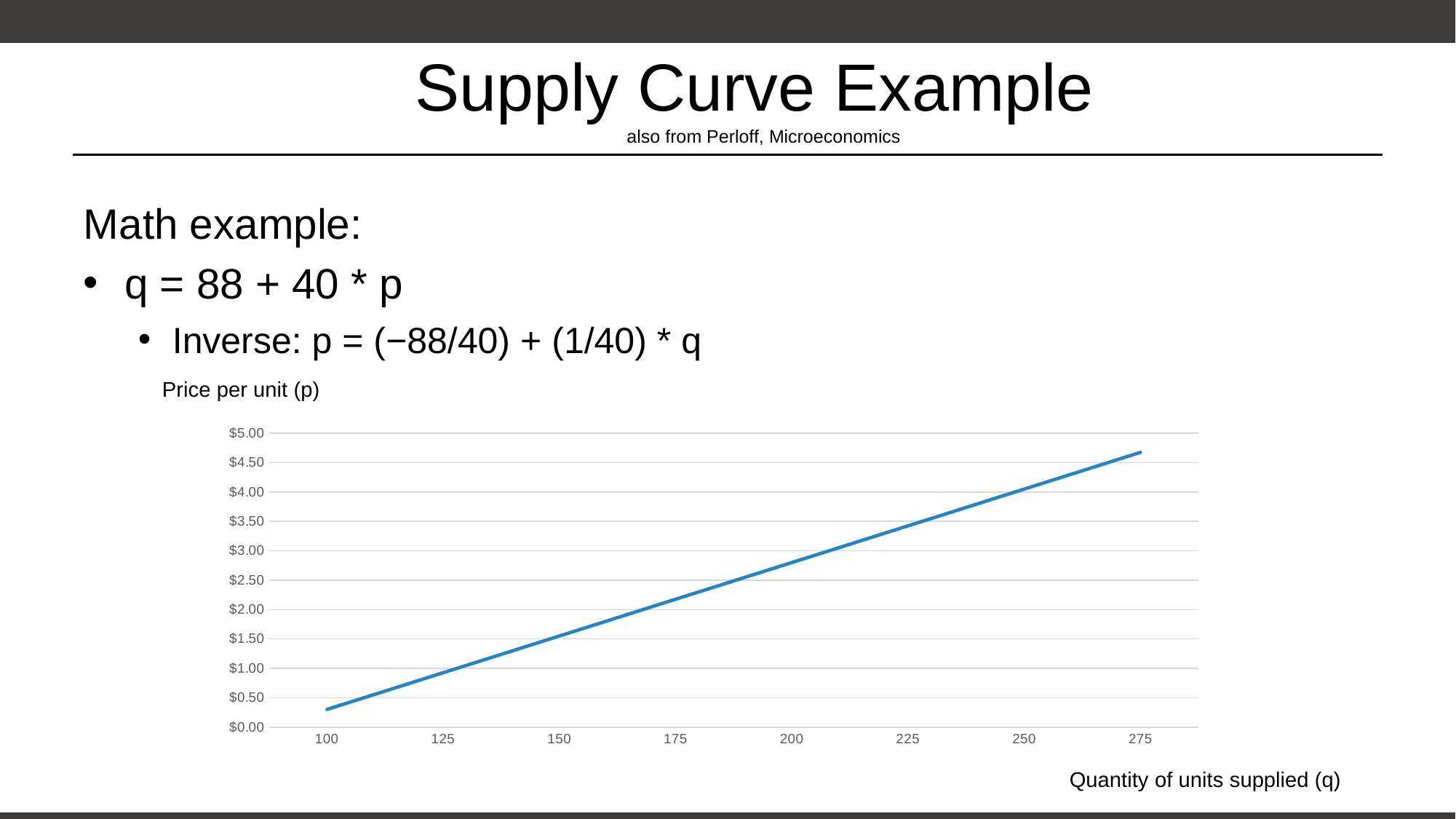
Is the price per unit at a quantity of 175 greater or less than $2.00? greater What kind of chart is shown on the slide? line chart Which has the higher price per unit: a quantity of 150 or a quantity of 250? 250 Is the price per unit at a quantity of 250 greater or less than $3.50? greater Is the price per unit at a quantity of 225 greater or less than $3.00? greater At which labelled quantity on the x axis is the price per unit lowest? 100 At which labelled quantity on the x axis is the price per unit highest? 275 What is the label of the vertical axis of the chart? Price per unit (p) Does the price per unit rise or fall as the quantity of units supplied increases along the x axis? rise